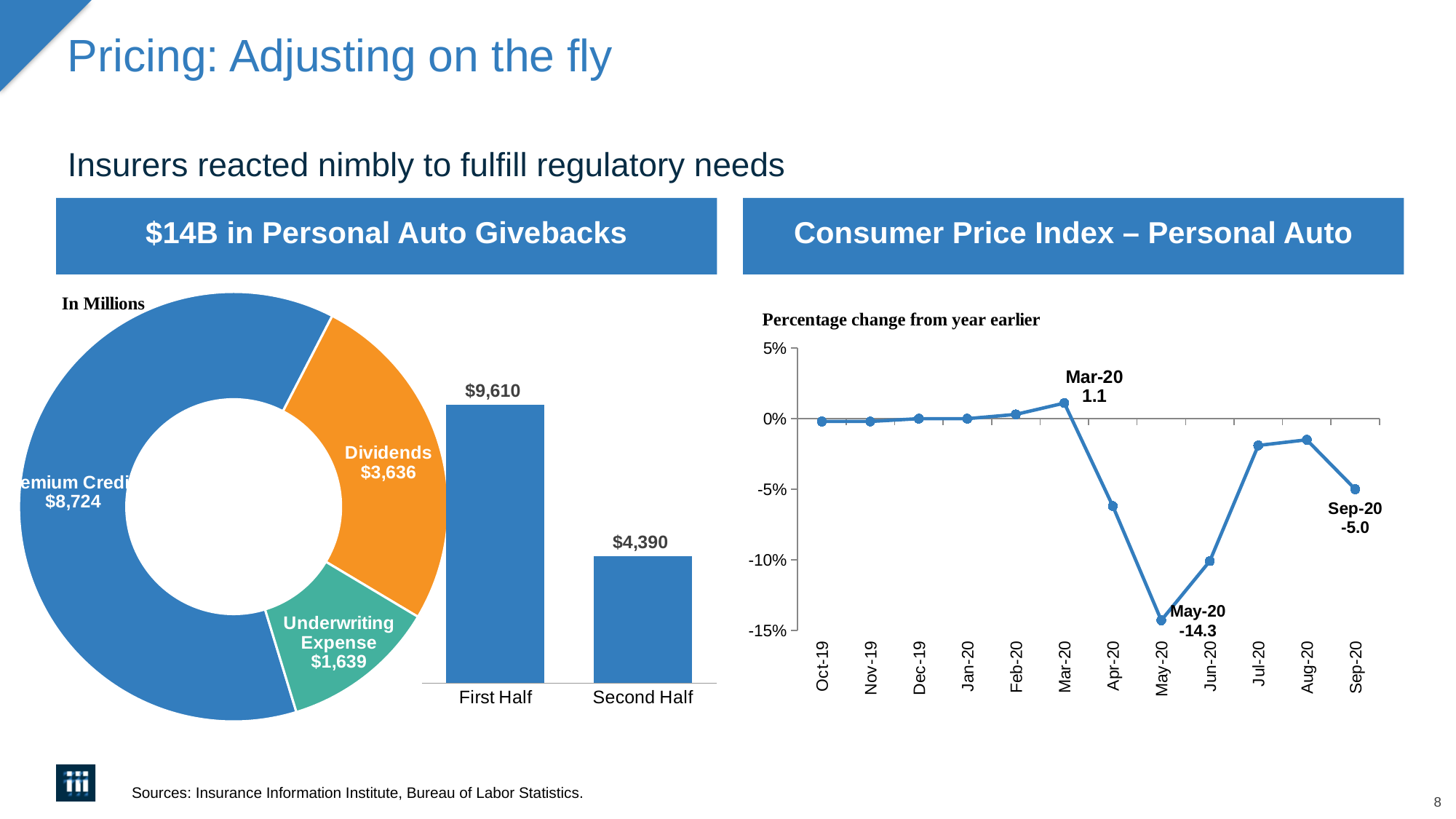
In the donut chart under '$14B in Personal Auto Givebacks', which category has the smallest slice? Underwriting Expense In the 'Consumer Price Index – Personal Auto' chart, what is the value for Mar-20? 1.1 In the 'Consumer Price Index – Personal Auto' chart, what is the value for May-20? -14.3 In the donut chart under '$14B in Personal Auto Givebacks', what is the value for Dividends? $3,636 In the bar chart under '$14B in Personal Auto Givebacks', what is the value for First Half? $9,610 In the bar chart under '$14B in Personal Auto Givebacks', what is the difference between the First Half and Second Half values? $5,220 In the 'Consumer Price Index – Personal Auto' chart, how many months are plotted on the x axis? 12 In the bar chart under '$14B in Personal Auto Givebacks', which is larger, First Half or Second Half? First Half In the 'Consumer Price Index – Personal Auto' chart, is the value for Apr-20 greater or less than -5%? less In the bar chart under '$14B in Personal Auto Givebacks', what is the value for Second Half? $4,390 In the 'Consumer Price Index – Personal Auto' chart, which month has the lowest value? May-20 In the donut chart under '$14B in Personal Auto Givebacks', what is the value for Underwriting Expense? $1,639